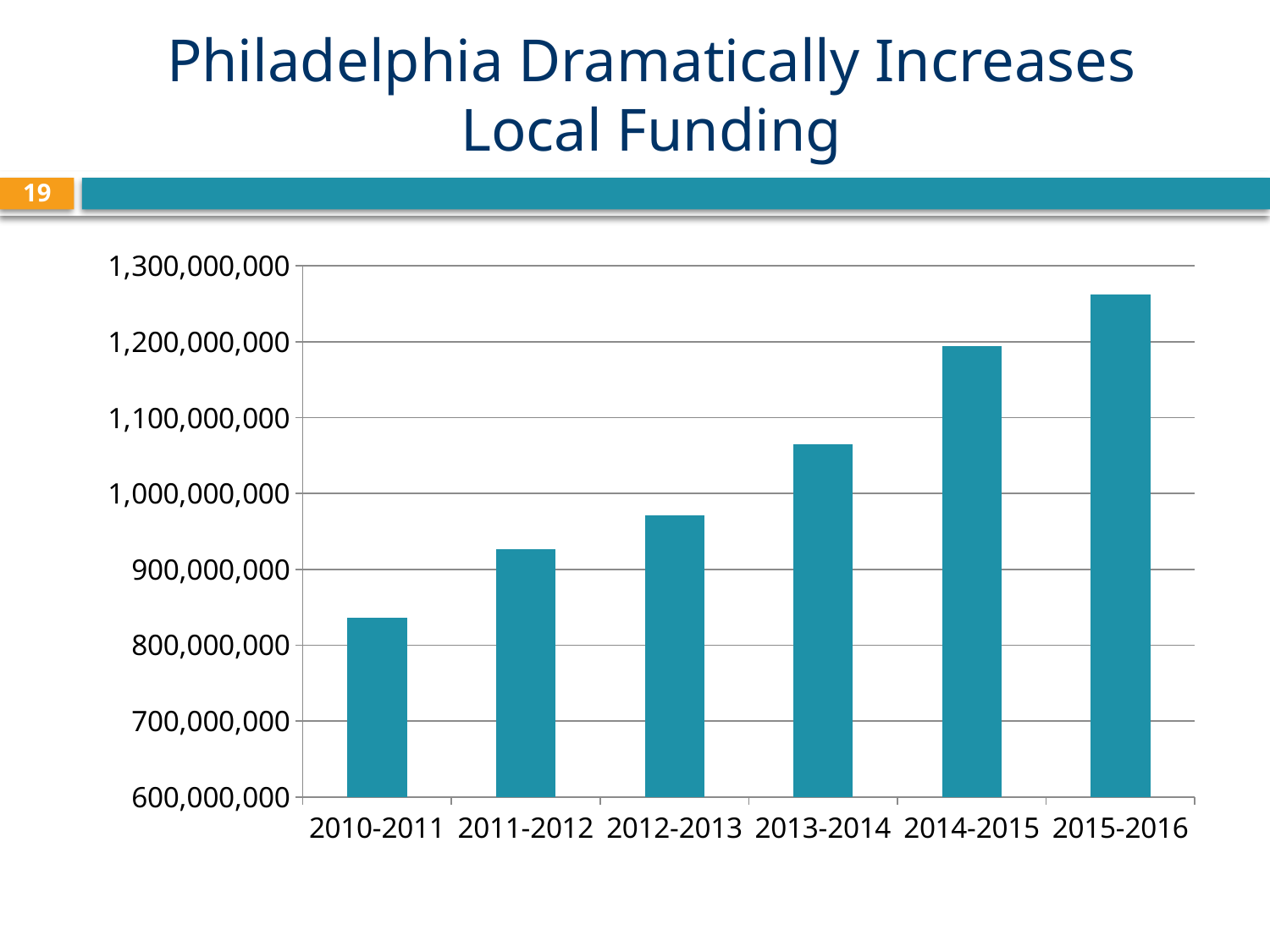
Is the value for 2015-2016 greater or less than 1,200,000,000? greater Is the value for 2010-2011 greater or less than 900,000,000? less What is the title of the slide containing the chart? Philadelphia Dramatically Increases Local Funding What is the lowest value shown on the y axis? 600,000,000 How many school years are shown on the x axis? 6 Which is larger, the value for 2011-2012 or the value for 2014-2015? 2014-2015 What kind of chart is shown on the slide? bar chart Which year has the lowest local funding? 2010-2011 Which year has the highest local funding? 2015-2016 Is the value for 2013-2014 greater or less than 1,000,000,000? greater Do the values rise or fall from 2010-2011 to 2015-2016? rise